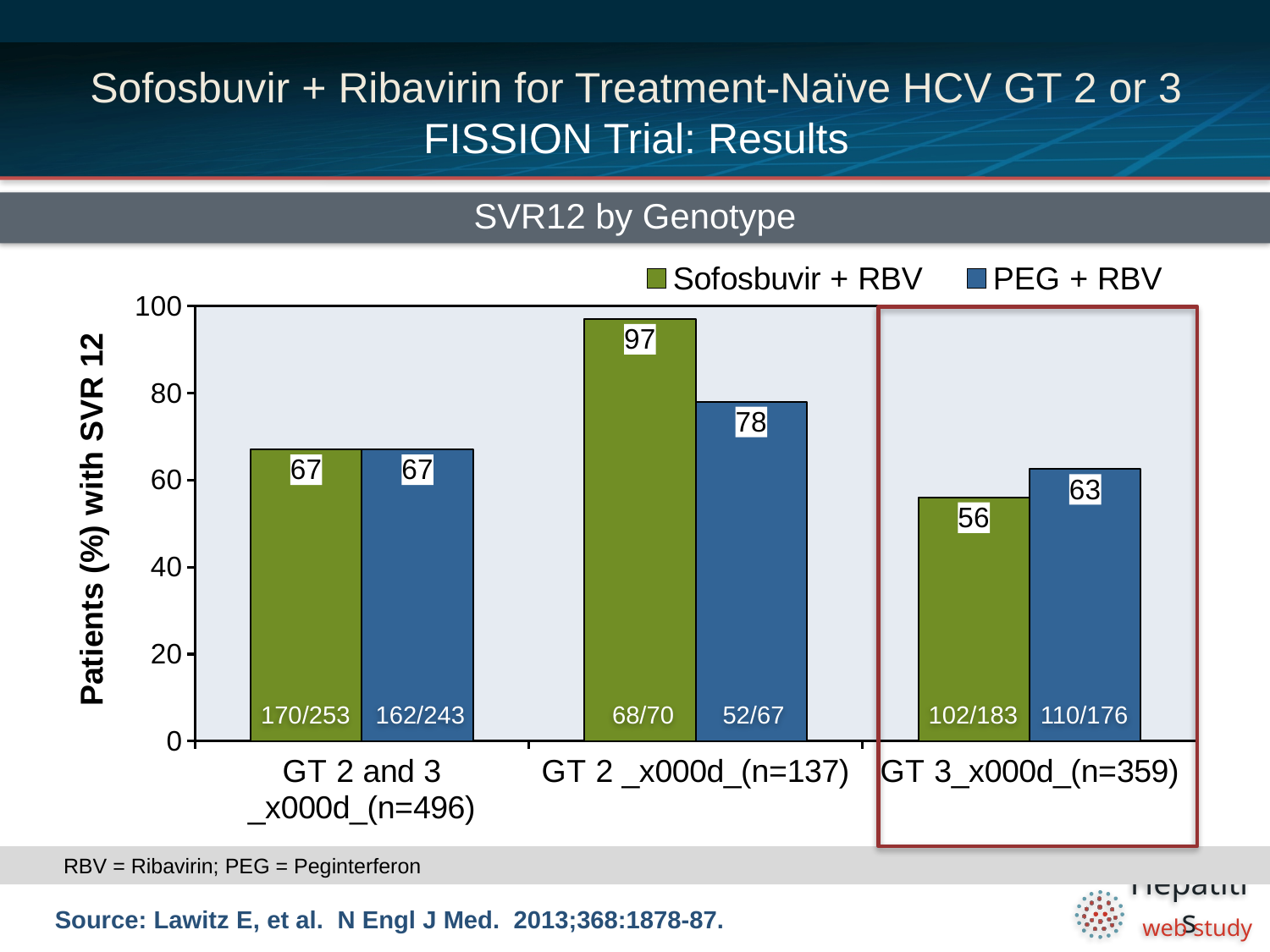
In the GT 3 (n=359) group, which treatment has the higher SVR12 rate, Sofosbuvir + RBV or PEG + RBV? PEG + RBV What fraction of patients is printed on the PEG + RBV bar for the GT 2 (n=137) group? 52/67 What is the difference between the Sofosbuvir + RBV and PEG + RBV SVR12 rates in the GT 2 (n=137) group? 19 How many genotype groups are shown on the x axis? 3 What is the SVR12 rate for Sofosbuvir + RBV in the GT 2 and 3 (n=496) group? 67 What is the SVR12 rate for PEG + RBV in the GT 3 (n=359) group? 63 What is the title of the chart? SVR12 by Genotype What kind of chart is shown on the slide? Bar chart Which genotype group has the lowest SVR12 rate for Sofosbuvir + RBV? GT 3 (n=359) Which genotype group has the highest SVR12 rate for Sofosbuvir + RBV? GT 2 (n=137) What is the SVR12 rate for Sofosbuvir + RBV in the GT 2 (n=137) group? 97 How many series does the legend list? 2